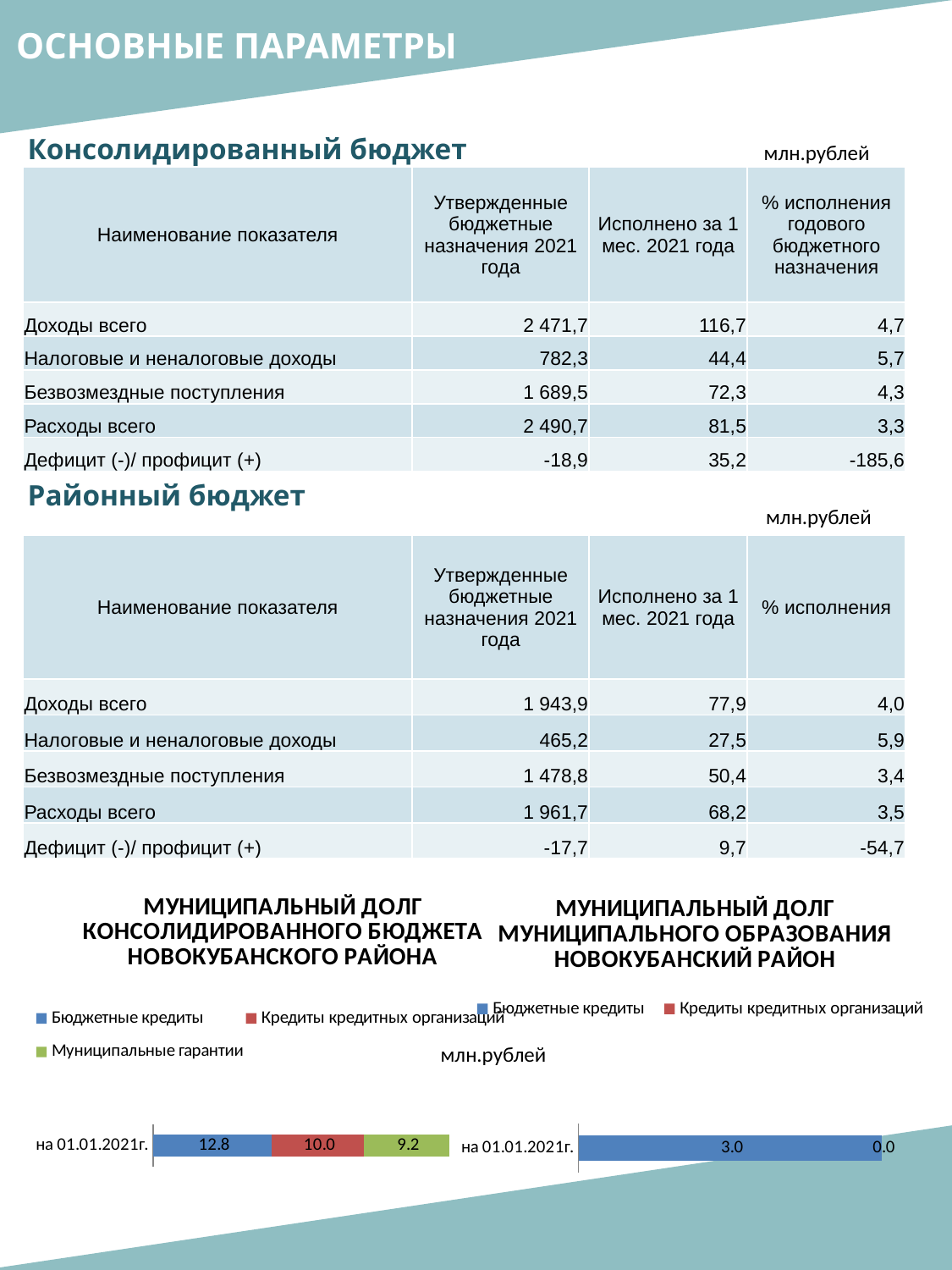
In the chart titled 'МУНИЦИПАЛЬНЫЙ ДОЛГ КОНСОЛИДИРОВАННОГО БЮДЖЕТА НОВОКУБАНСКОГО РАЙОНА', what is the difference between Бюджетные кредиты and Муниципальные гарантии? 3.6 In the chart titled 'МУНИЦИПАЛЬНЫЙ ДОЛГ МУНИЦИПАЛЬНОГО ОБРАЗОВАНИЯ НОВОКУБАНСКИЙ РАЙОН', what is the value for Бюджетные кредиты? 3.0 In the chart titled 'МУНИЦИПАЛЬНЫЙ ДОЛГ КОНСОЛИДИРОВАННОГО БЮДЖЕТА НОВОКУБАНСКОГО РАЙОНА', what is the value for Муниципальные гарантии? 9.2 In the chart titled 'МУНИЦИПАЛЬНЫЙ ДОЛГ КОНСОЛИДИРОВАННОГО БЮДЖЕТА НОВОКУБАНСКОГО РАЙОНА', what is the value for Бюджетные кредиты on 01.01.2021? 12.8 In the chart titled 'МУНИЦИПАЛЬНЫЙ ДОЛГ КОНСОЛИДИРОВАННОГО БЮДЖЕТА НОВОКУБАНСКОГО РАЙОНА', what is the total of the stacked bar for 01.01.2021? 32.0 In the chart titled 'МУНИЦИПАЛЬНЫЙ ДОЛГ КОНСОЛИДИРОВАННОГО БЮДЖЕТА НОВОКУБАНСКОГО РАЙОНА', which series has the smallest value? Муниципальные гарантии What kind of chart is the chart titled 'МУНИЦИПАЛЬНЫЙ ДОЛГ МУНИЦИПАЛЬНОГО ОБРАЗОВАНИЯ НОВОКУБАНСКИЙ РАЙОН'? Bar chart In the chart titled 'МУНИЦИПАЛЬНЫЙ ДОЛГ КОНСОЛИДИРОВАННОГО БЮДЖЕТА НОВОКУБАНСКОГО РАЙОНА', what is the value for Кредиты кредитных организаций? 10.0 In the chart titled 'МУНИЦИПАЛЬНЫЙ ДОЛГ МУНИЦИПАЛЬНОГО ОБРАЗОВАНИЯ НОВОКУБАНСКИЙ РАЙОН', what is the value for Кредиты кредитных организаций? 0.0 How many series does the legend of the chart titled 'МУНИЦИПАЛЬНЫЙ ДОЛГ КОНСОЛИДИРОВАННОГО БЮДЖЕТА НОВОКУБАНСКОГО РАЙОНА' list? 3 In the chart titled 'МУНИЦИПАЛЬНЫЙ ДОЛГ МУНИЦИПАЛЬНОГО ОБРАЗОВАНИЯ НОВОКУБАНСКИЙ РАЙОН', which is larger: Бюджетные кредиты or Кредиты кредитных организаций? Бюджетные кредиты In the chart titled 'МУНИЦИПАЛЬНЫЙ ДОЛГ КОНСОЛИДИРОВАННОГО БЮДЖЕТА НОВОКУБАНСКОГО РАЙОНА', which series has the largest value? Бюджетные кредиты